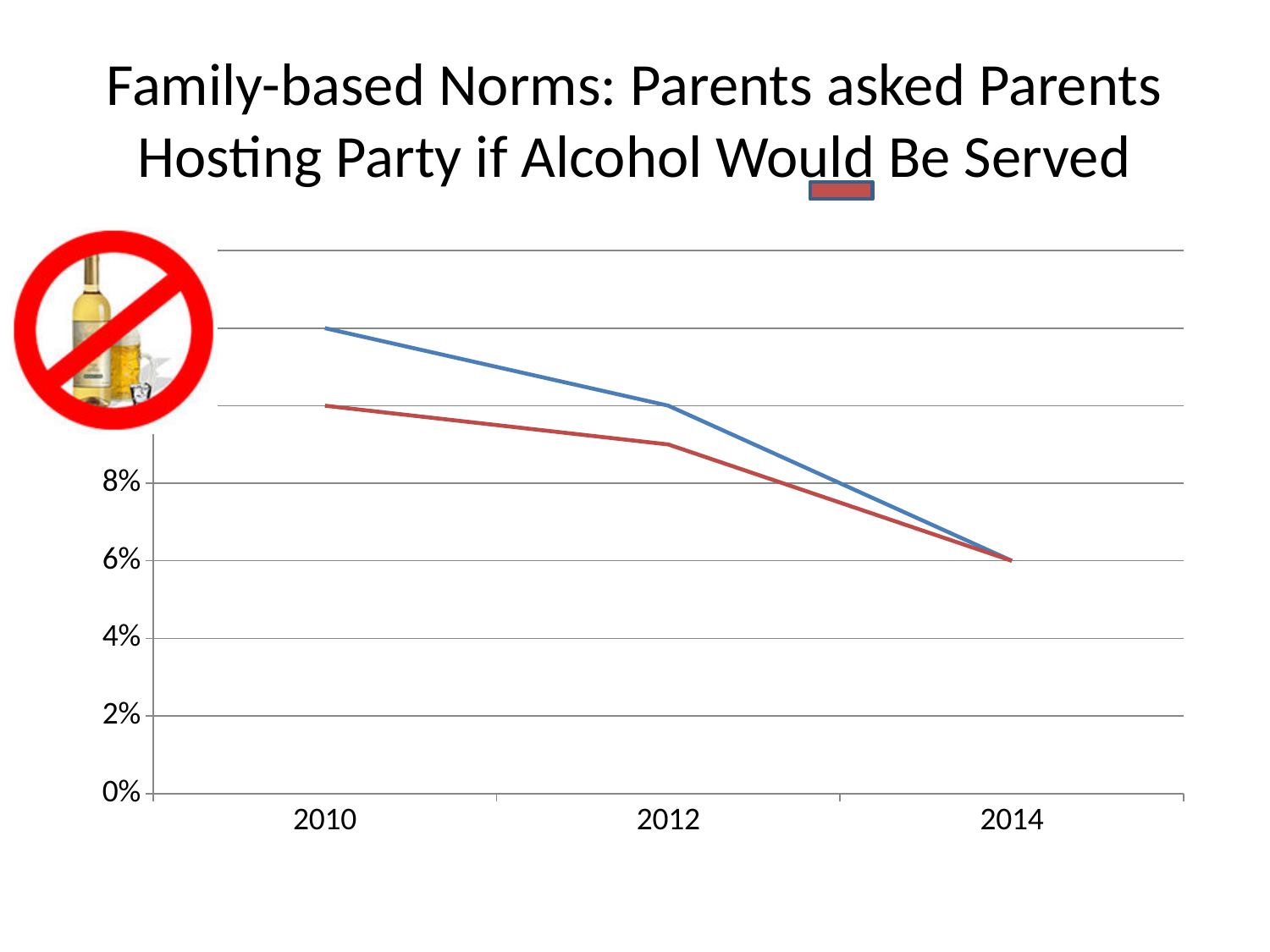
What is the value of the blue line in 2014? 6% Is the value of the red line in 2012 greater or less than 8%? greater What is the value of the red line in 2014? 6% Do the values of the blue line rise or fall from 2010 to 2014? fall How many lines are plotted on the chart? 2 In 2010, which line has the higher value, the blue line or the red line? the blue line In which year does the blue line reach its lowest value? 2014 Is the value of the blue line in 2010 greater or less than 8%? greater How many years are plotted along the x axis? 3 Do the values of the red line rise or fall from 2010 to 2014? fall What kind of chart is shown on the slide? line chart What is the title of the slide's chart? Family-based Norms: Parents asked Parents Hosting Party if Alcohol Would Be Served